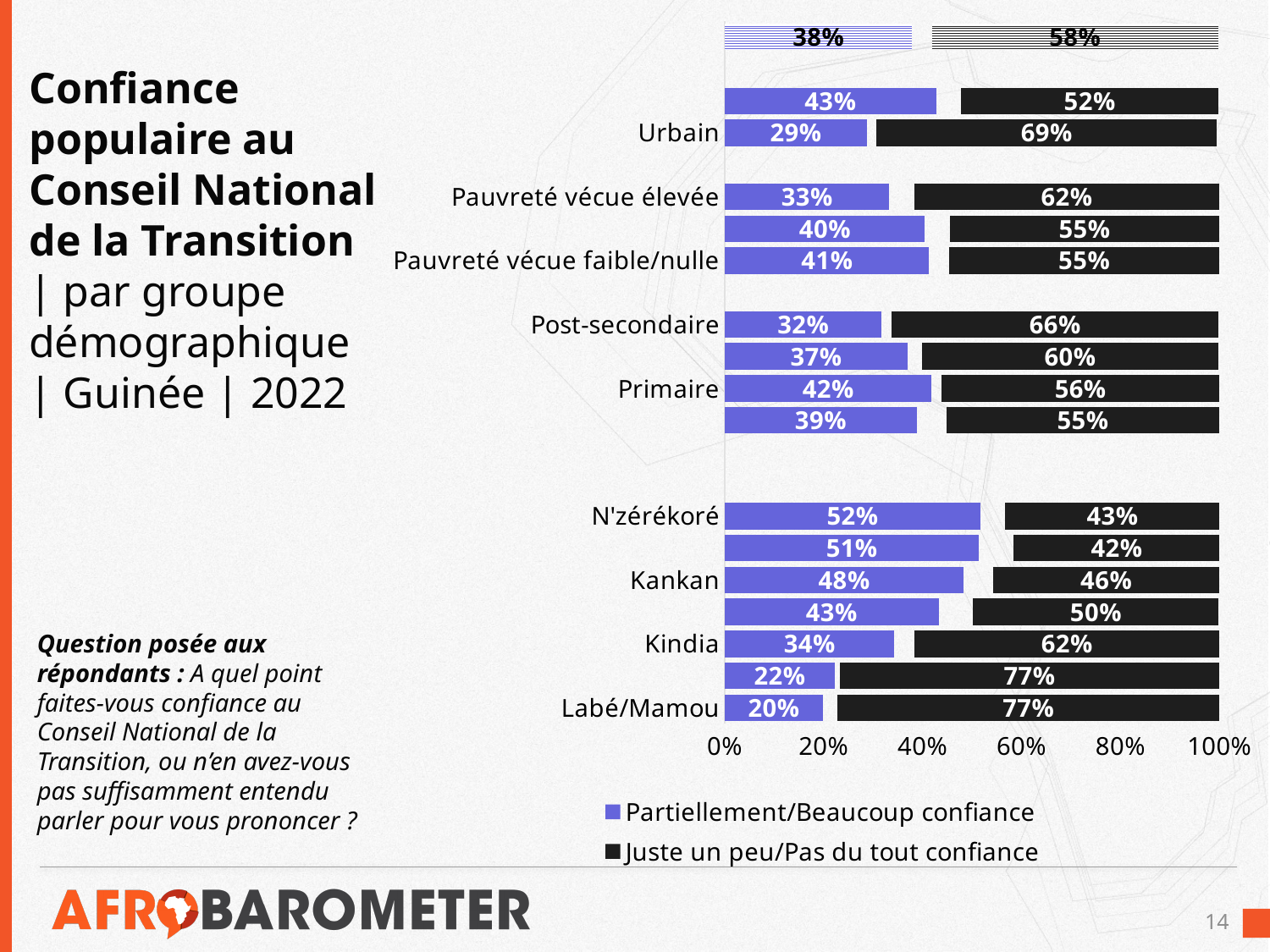
What kind of chart is shown on the slide? Stacked bar chart What is the value for Labé/Mamou in the 'Juste un peu/Pas du tout confiance' series? 77% What is the value for Urbain in the 'Partiellement/Beaucoup confiance' series? 29% How many series does the legend list? 2 Which colour represents the 'Juste un peu/Pas du tout confiance' series? Black Among the labelled categories, which has the lowest 'Partiellement/Beaucoup confiance' value? Labé/Mamou Among the labelled categories, which has the highest 'Juste un peu/Pas du tout confiance' value? Labé/Mamou What is the difference between the 'Juste un peu/Pas du tout confiance' values for Urbain and Kindia? 7% Which is larger: the 'Partiellement/Beaucoup confiance' value for Kankan or for Kindia? Kankan What is the total of the two labelled segments for the Primaire bar? 98% What is the value for Post-secondaire in the 'Juste un peu/Pas du tout confiance' series? 66% What is the value for N'zérékoré in the 'Partiellement/Beaucoup confiance' series? 52%